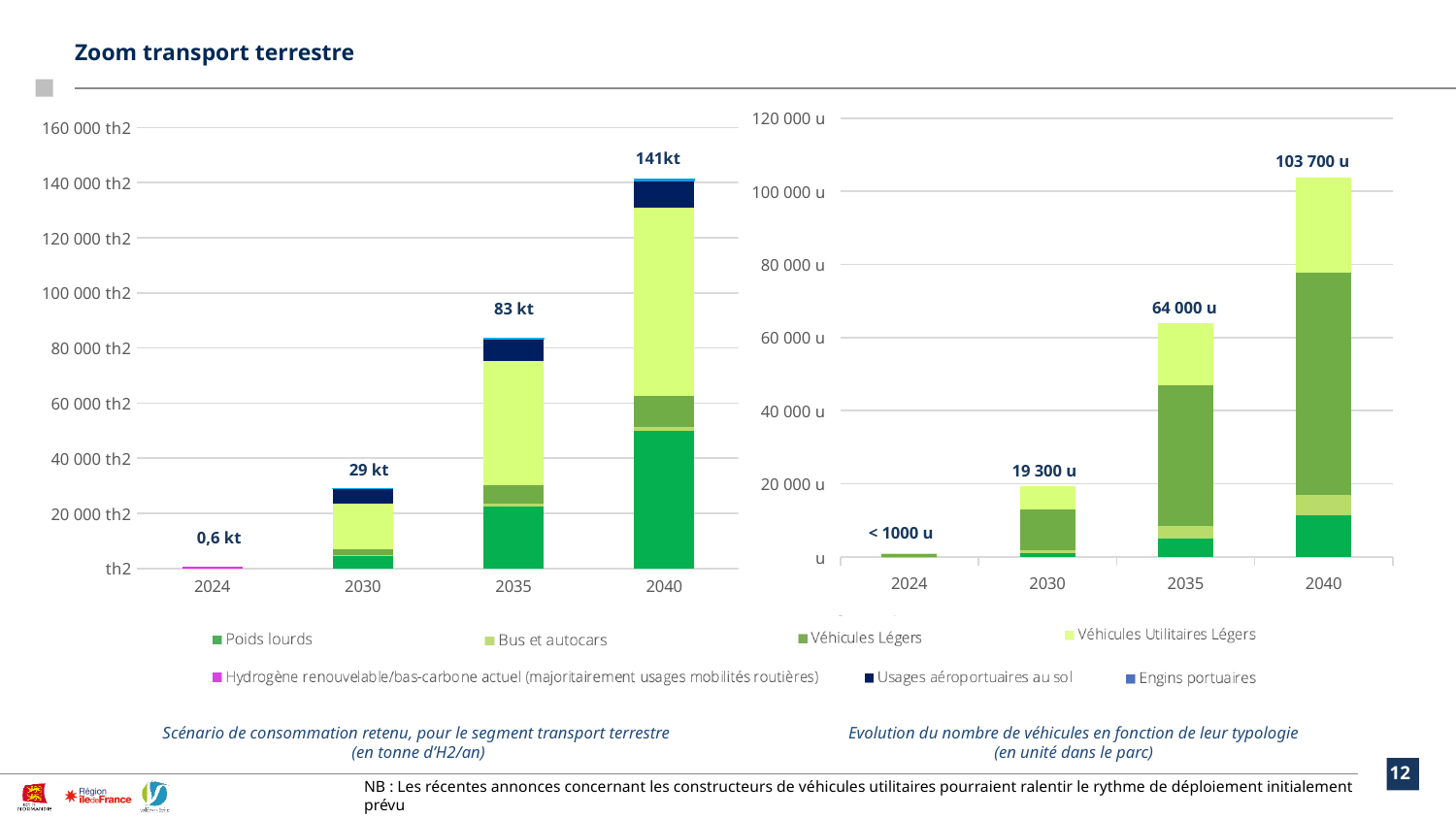
In the left chart (Scénario de consommation retenu), what is the difference between the 2040 total and the 2035 total? 58 kt In the left chart (Scénario de consommation retenu), what is the total value labelled for 2040? 141kt In the right chart (Evolution du nombre de véhicules), what is the difference between the 2040 total and the 2035 total? 39 700 u In the left chart (Scénario de consommation retenu), what is the total value labelled for 2035? 83 kt In the right chart (Evolution du nombre de véhicules), do the totals rise or fall from 2024 to 2040? rise In the right chart (Evolution du nombre de véhicules), what is the total value labelled for 2040? 103 700 u In the right chart (Evolution du nombre de véhicules), what label is shown above the 2024 bar? < 1000 u In the right chart (Evolution du nombre de véhicules), which year has the lowest total? 2024 In the right chart (Evolution du nombre de véhicules), what is the total value labelled for 2030? 19 300 u How many years (categories) are shown on the x axis of the left chart (Scénario de consommation retenu)? 4 In the left chart (Scénario de consommation retenu), what is the total value labelled for 2024? 0,6 kt In the left chart (Scénario de consommation retenu), which year has the highest total? 2040